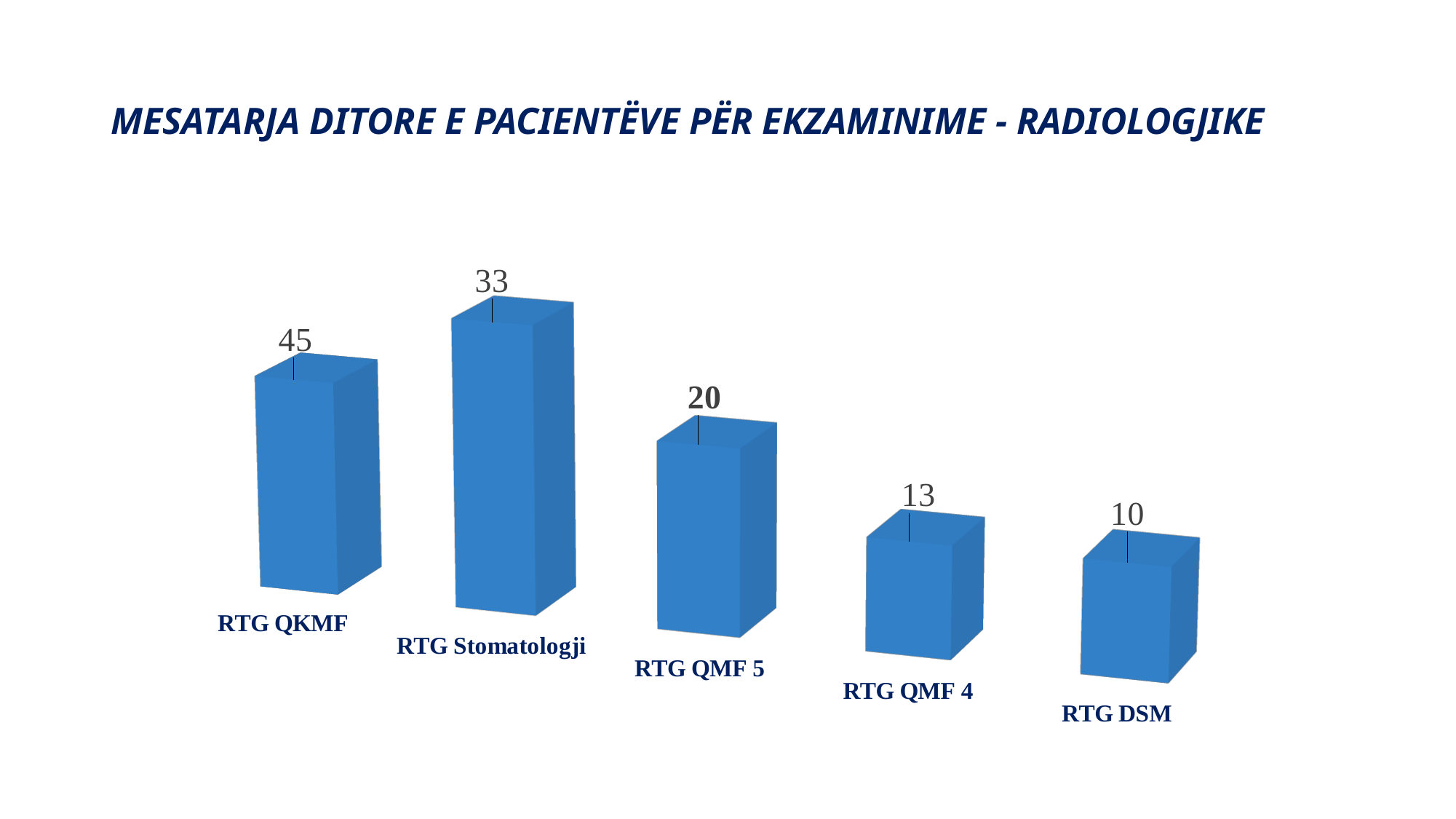
Which is larger, the value for RTG QMF 4 or the value for RTG DSM? RTG QMF 4 What is the value for RTG QMF 5? 20 What is the value for RTG DSM? 10 What is the difference between the values for RTG QMF 5 and RTG DSM? 10 Which category has the lowest value? RTG DSM What is the value for RTG Stomatologji? 33 What is the value for RTG QKMF? 45 What is the difference between the values for RTG QKMF and RTG Stomatologji? 12 What is the value for RTG QMF 4? 13 How many categories are shown in the chart? 5 What kind of chart is shown on the slide? Bar chart Which category has the highest value according to the data labels? RTG QKMF